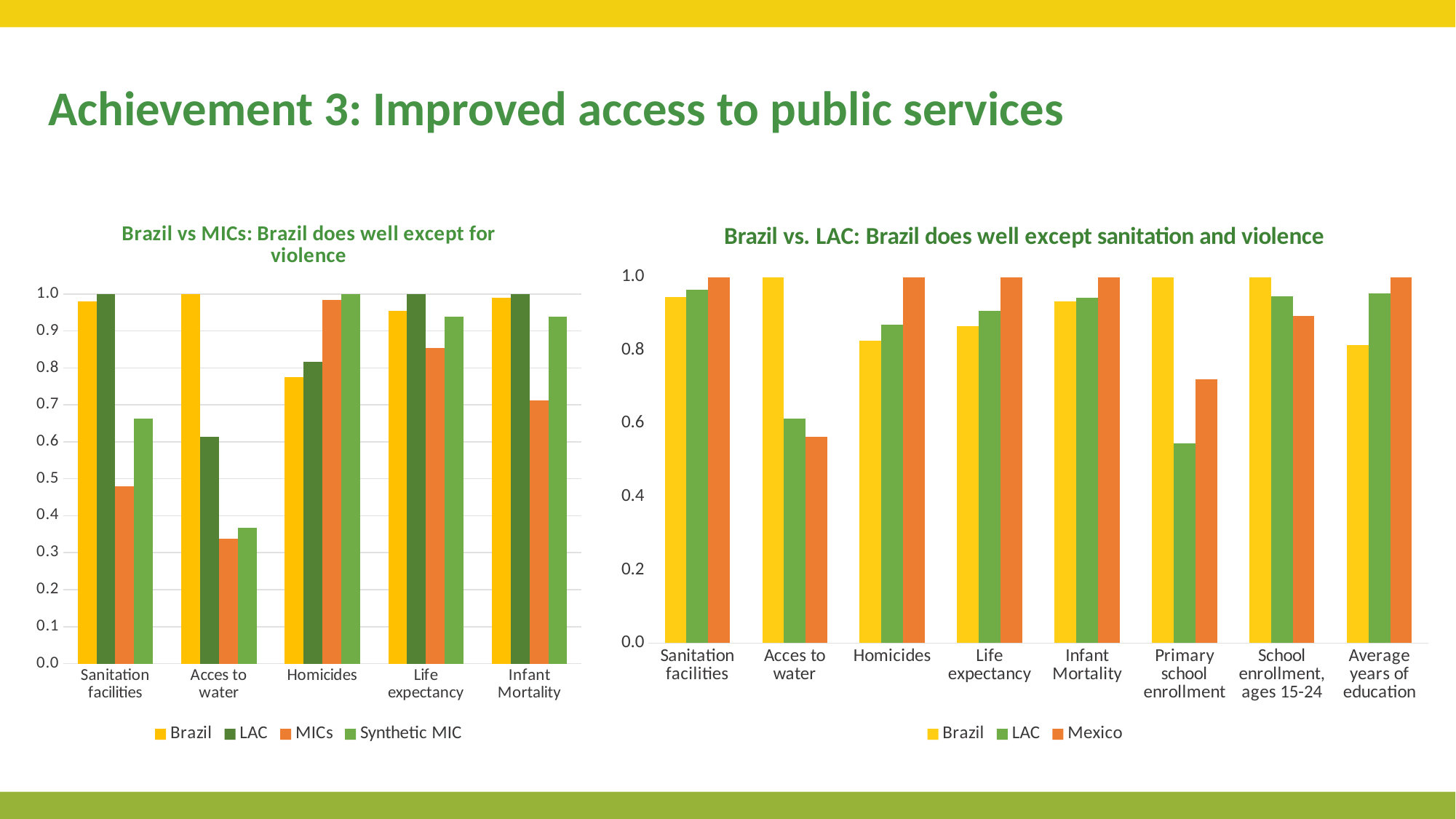
In the left chart (Brazil vs MICs), what is the value for Brazil in the Acces to water category? 1.0 In the right chart (Brazil vs. LAC), which is larger in the Acces to water category, the value for Brazil or the value for Mexico? Brazil In the left chart (Brazil vs MICs), what is the value for LAC in the Sanitation facilities category? 1.0 In the right chart (Brazil vs. LAC), which series has the lowest value in the Average years of education category? Brazil In the left chart (Brazil vs MICs), is the value for MICs in the Acces to water category greater or less than 0.4? less How many series does the legend of the right chart (Brazil vs. LAC) list? 3 How many categories are shown on the x axis of the right chart (Brazil vs. LAC)? 8 In the left chart (Brazil vs MICs), which series has the lowest value in the Homicides category? Brazil In the left chart (Brazil vs MICs), which series has the lowest value in the Sanitation facilities category? MICs In the right chart (Brazil vs. LAC), is the value for LAC in the Primary school enrollment category greater or less than 0.6? less What type of chart is the left chart titled 'Brazil vs MICs: Brazil does well except for violence'? bar chart How many series does the legend of the left chart (Brazil vs MICs) list? 4